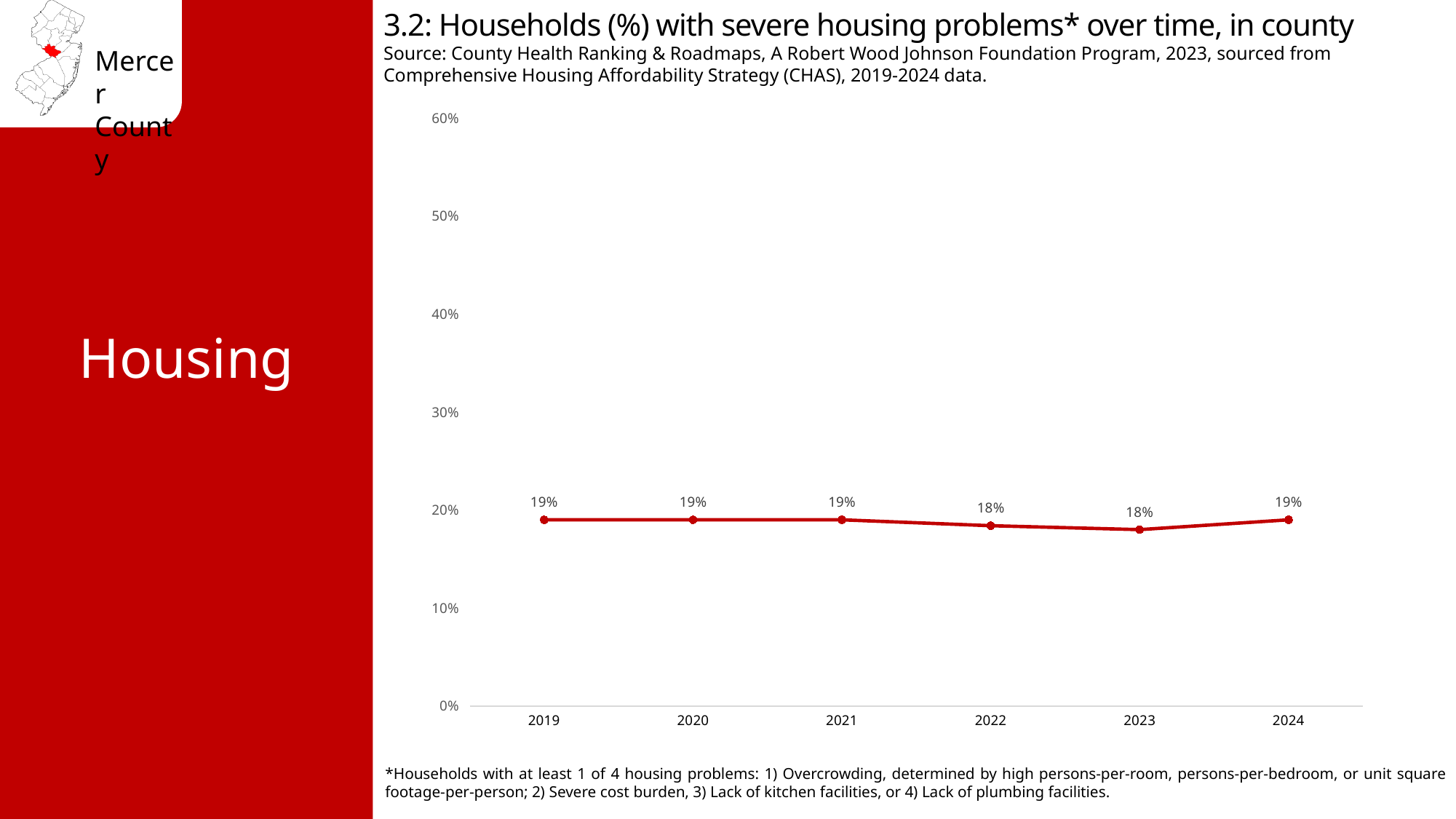
What is the title of the chart? 3.2: Households (%) with severe housing problems* over time, in county Which of 2021 or 2022 has the larger value? 2021 What is the value for 2024? 19% What is the difference between the values for 2021 and 2022? 1% Is the value for 2020 greater or less than 30%? less What is the value for 2019? 19% Is the value for 2023 greater or less than 10%? greater How many years are plotted on the x axis? 6 What is the value for 2023? 18% What kind of chart is shown on the slide? line chart What is the highest value shown on the y axis? 60% What is the value for 2022? 18%